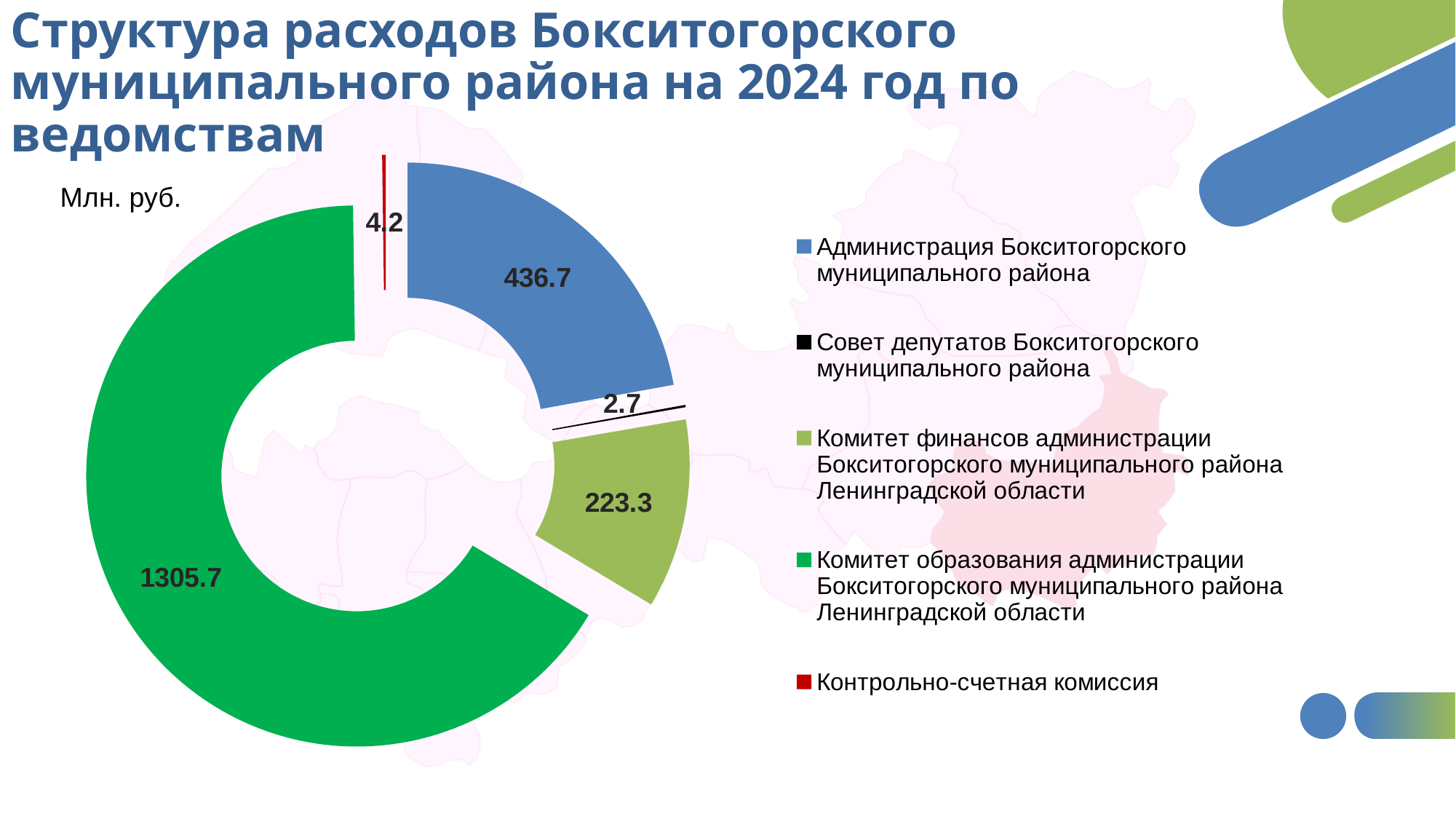
Which category has the highest value? Комитет образования администрации Бокситогорского муниципального района Ленинградской области How many categories does the legend list? 5 What is the value for Контрольно-счетная комиссия? 4.2 What type of chart is shown on the slide? Doughnut (pie) chart What is the value for Администрация Бокситогорского муниципального района? 436.7 Which is larger: the value for Администрация Бокситогорского муниципального района or for Комитет финансов? Администрация Бокситогорского муниципального района What is the value for Комитет финансов администрации Бокситогорского муниципального района Ленинградской области? 223.3 Which category has the lowest value? Совет депутатов Бокситогорского муниципального района What is the value for Совет депутатов Бокситогорского муниципального района? 2.7 What is the value for Комитет образования администрации Бокситогорского муниципального района Ленинградской области? 1305.7 What is the difference between the values for Комитет образования and Администрация Бокситогорского муниципального района? 869.0 What unit is indicated for the values on the chart? Млн. руб.